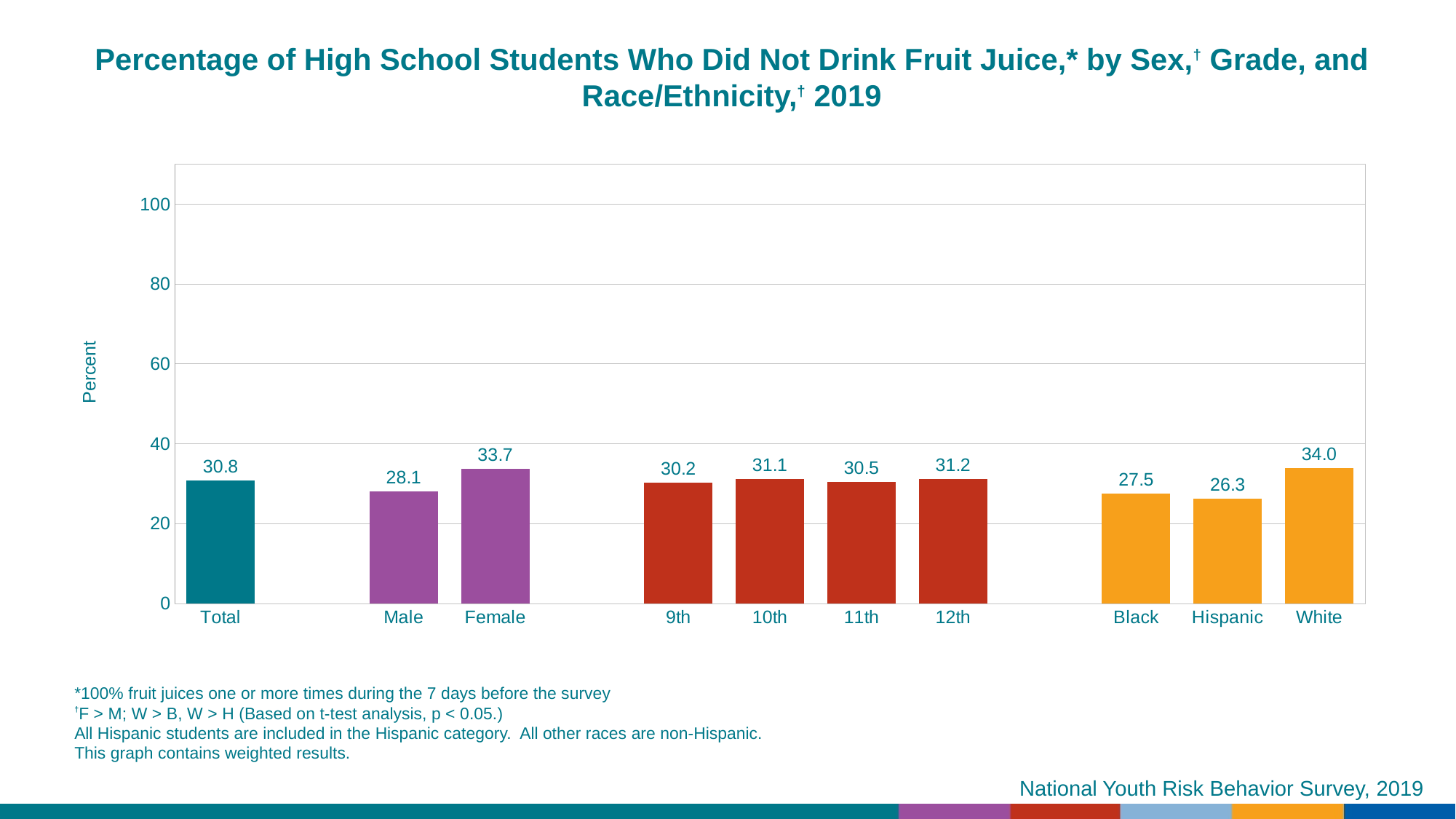
What is the label of the y axis? Percent How many categories are shown on the x axis? 10 What is the value for Total? 30.8 Is the value for 12th greater or less than 40? less What kind of chart is this? bar chart Which is larger, the value for White or the value for Black? White What is the value for Hispanic? 26.3 What is the difference between the White and Hispanic values? 7.7 Which category has the highest value? White What is the value for Female? 33.7 What is the difference between the Female and Male values? 5.6 Which category has the lowest value? Hispanic